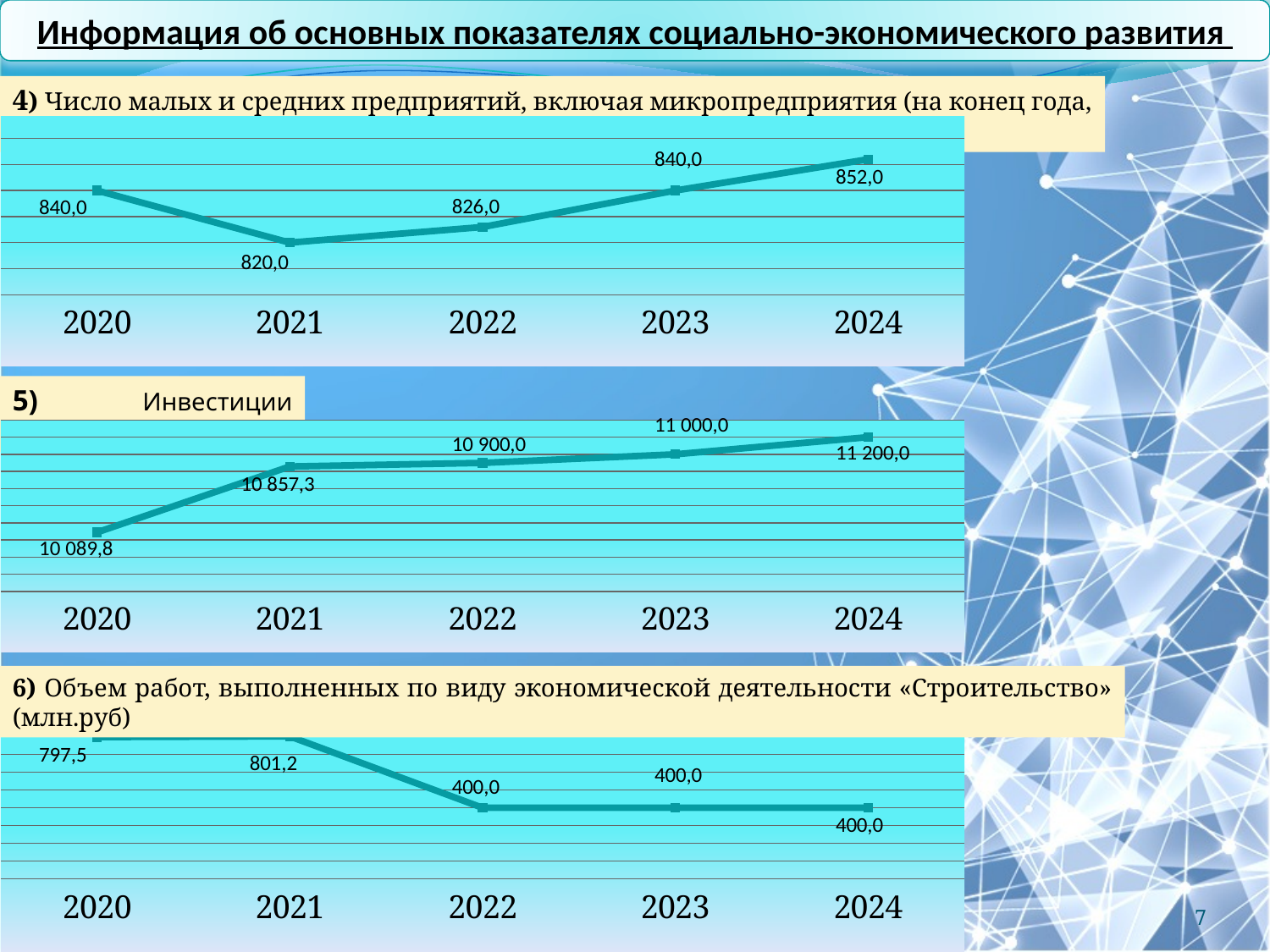
In the middle chart (Инвестиции), what is the value for 2024? 11 200,0 How many years are plotted on the x axis of the bottom chart (construction work volume)? 5 In the bottom chart (construction work volume, млн.руб), what is the value for 2021? 801,2 In the bottom chart (construction work volume, млн.руб), what is the difference between the 2021 value and the 2022 value? 401,2 In the top chart (number of small and medium enterprises), what is the value for 2021? 820,0 In the middle chart (Инвестиции), do the values rise or fall from 2020 to 2024? rise In the middle chart (Инвестиции), what is the value for 2020? 10 089,8 In the bottom chart (construction work volume, млн.руб), which is larger, the value for 2020 or the value for 2022? 2020 In the top chart (number of small and medium enterprises), which year has the highest value? 2024 In the middle chart (Инвестиции), what is the difference between the 2024 value and the 2020 value? 1 110,2 In the top chart (number of small and medium enterprises), what is the difference between the 2024 value and the 2021 value? 32,0 In the top chart (number of small and medium enterprises), which year has the lowest value? 2021